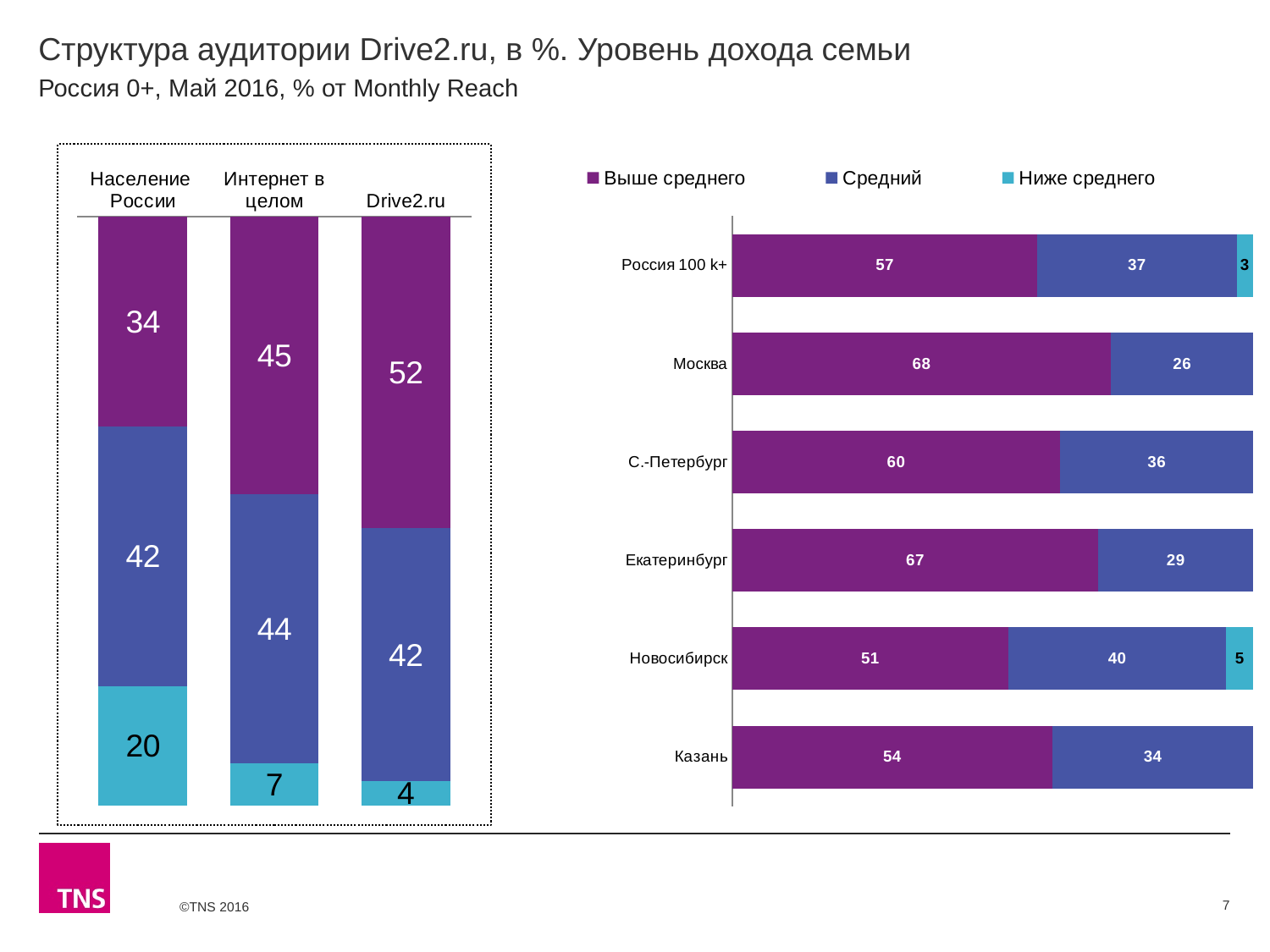
In the right chart, what is the 'Средний' value for Новосибирск? 40 How many categories are shown on the right chart? 6 In the right chart, what is the 'Выше среднего' value for Москва? 68 In the left chart, which has a larger 'Ниже среднего' value: Интернет в целом or Drive2.ru? Интернет в целом In the left chart, what is the value of the 'Средний' segment for Интернет в целом? 44 In the left chart, what is the value of the 'Выше среднего' segment for Drive2.ru? 52 How many series does the legend of the right chart list? 3 In the left chart, what is the value of the 'Ниже среднего' segment for Население России? 20 In the right chart, which category has the lowest 'Выше среднего' value? Новосибирск What type of chart is the right chart? Stacked bar chart In the right chart, which city has the highest 'Выше среднего' value? Москва In the right chart, what is the difference between the 'Выше среднего' values for Москва and Казань? 14